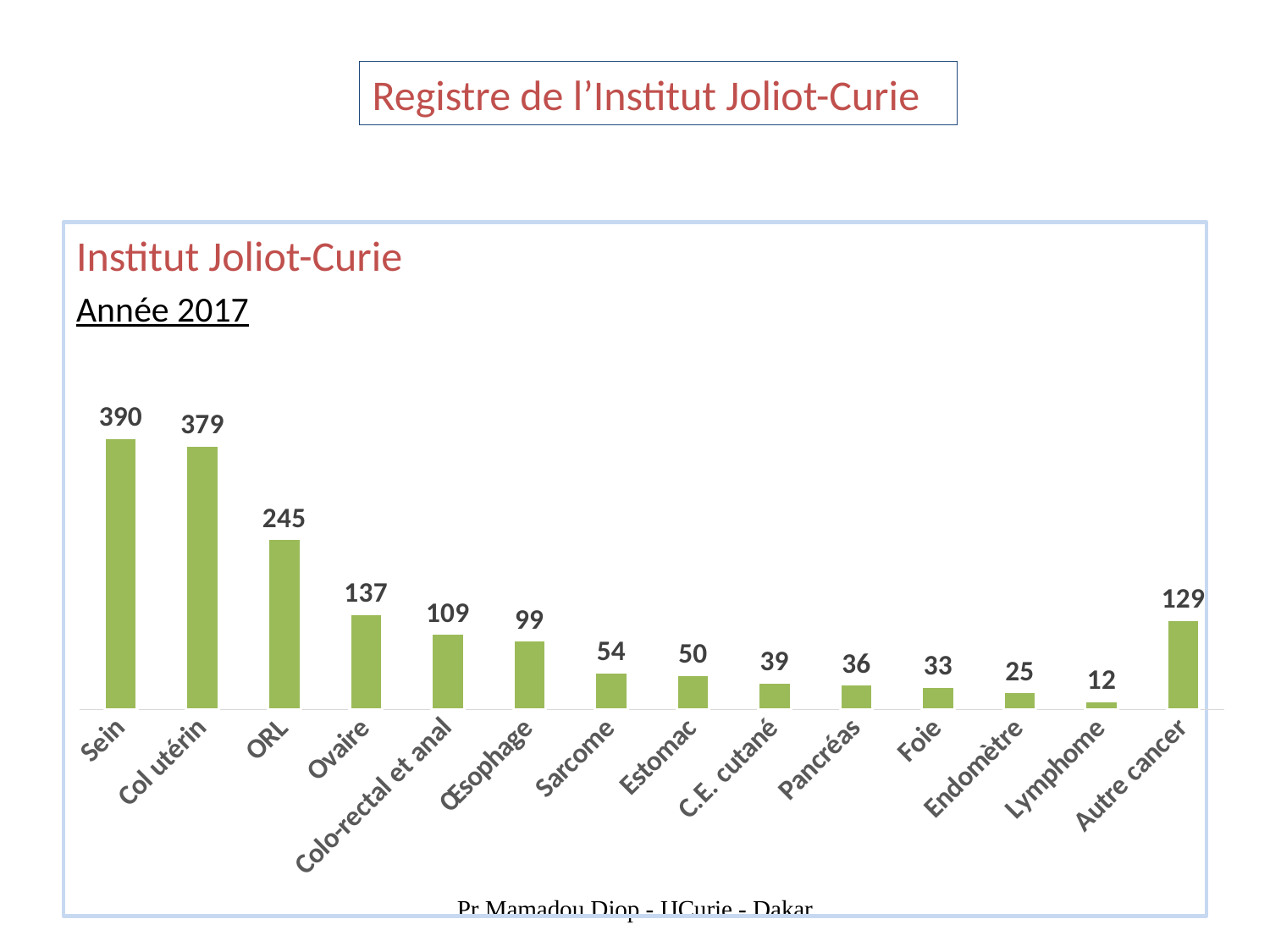
How many categories are shown on the x axis? 14 Which category has the highest value? Sein What is the value for Sein? 390 What is the value for Pancréas? 36 What is the difference between the values for Sein and Col utérin? 11 What year does the chart cover, according to the text above it? 2017 What kind of chart is shown? Bar chart What is the difference between the values for ORL and Ovaire? 108 Which category has the lowest value? Lymphome What is the value for Autre cancer? 129 What is the value for ORL? 245 Which is larger, the value for Colo-rectal et anal or the value for Autre cancer? Autre cancer